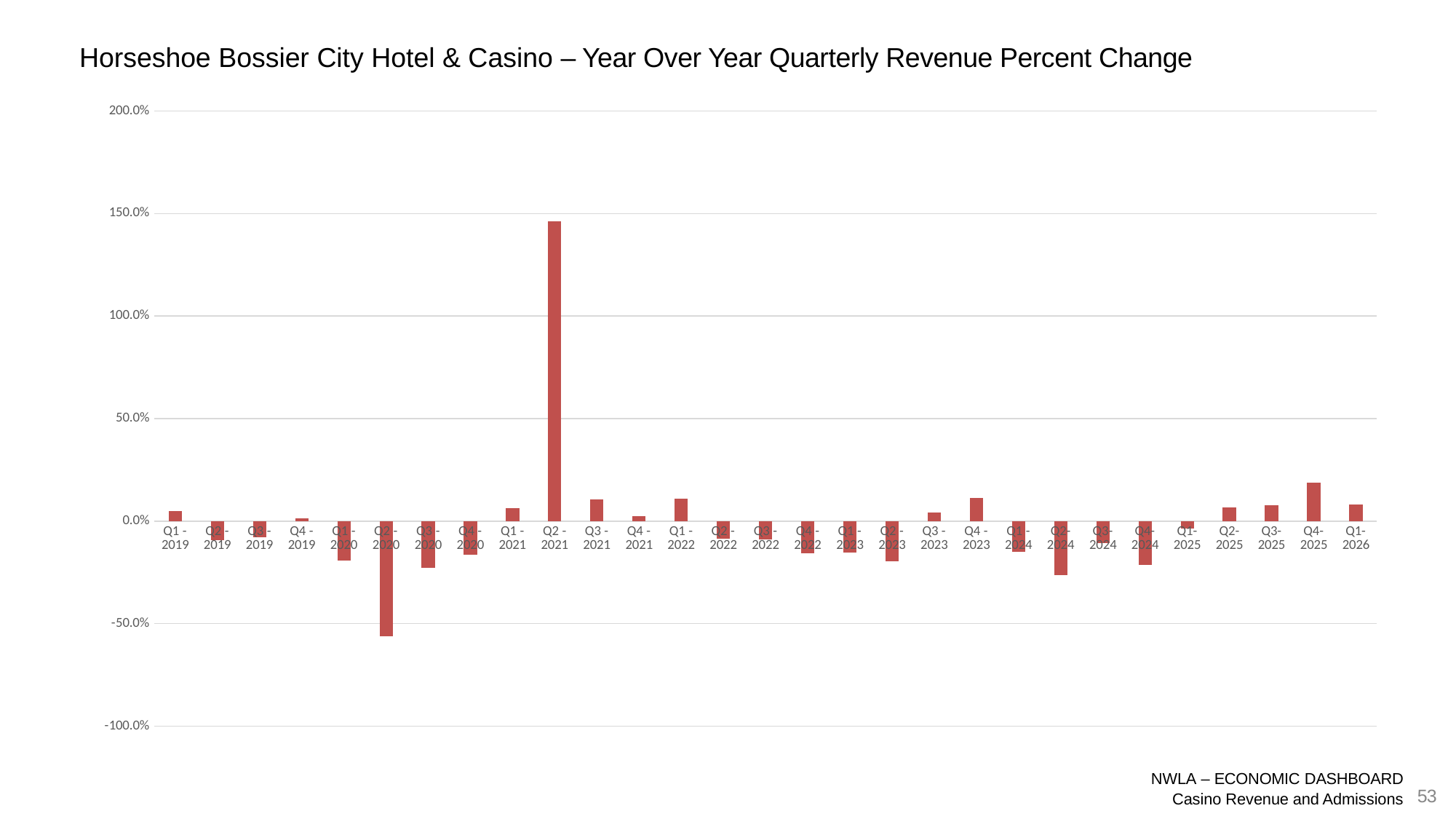
Which quarter has the highest year-over-year revenue percent change? Q2 - 2021 What colour are the bars in the chart? Red What is the title of the chart? Horseshoe Bossier City Hotel & Casino – Year Over Year Quarterly Revenue Percent Change What kind of chart is shown on the slide? Bar chart Is the value for Q2 - 2021 greater or less than 100.0%? greater Which is larger, the value for Q2 - 2021 or the value for Q4 - 2025? Q2 - 2021 Is the value for Q2 - 2024 greater or less than 0.0%? less Which quarter has the lowest year-over-year revenue percent change? Q2 - 2020 Is the value for Q4 - 2025 greater or less than 50.0%? less Which is larger, the value for Q4 - 2025 or the value for Q1 - 2026? Q4 - 2025 How many quarters are plotted on the x axis? 29